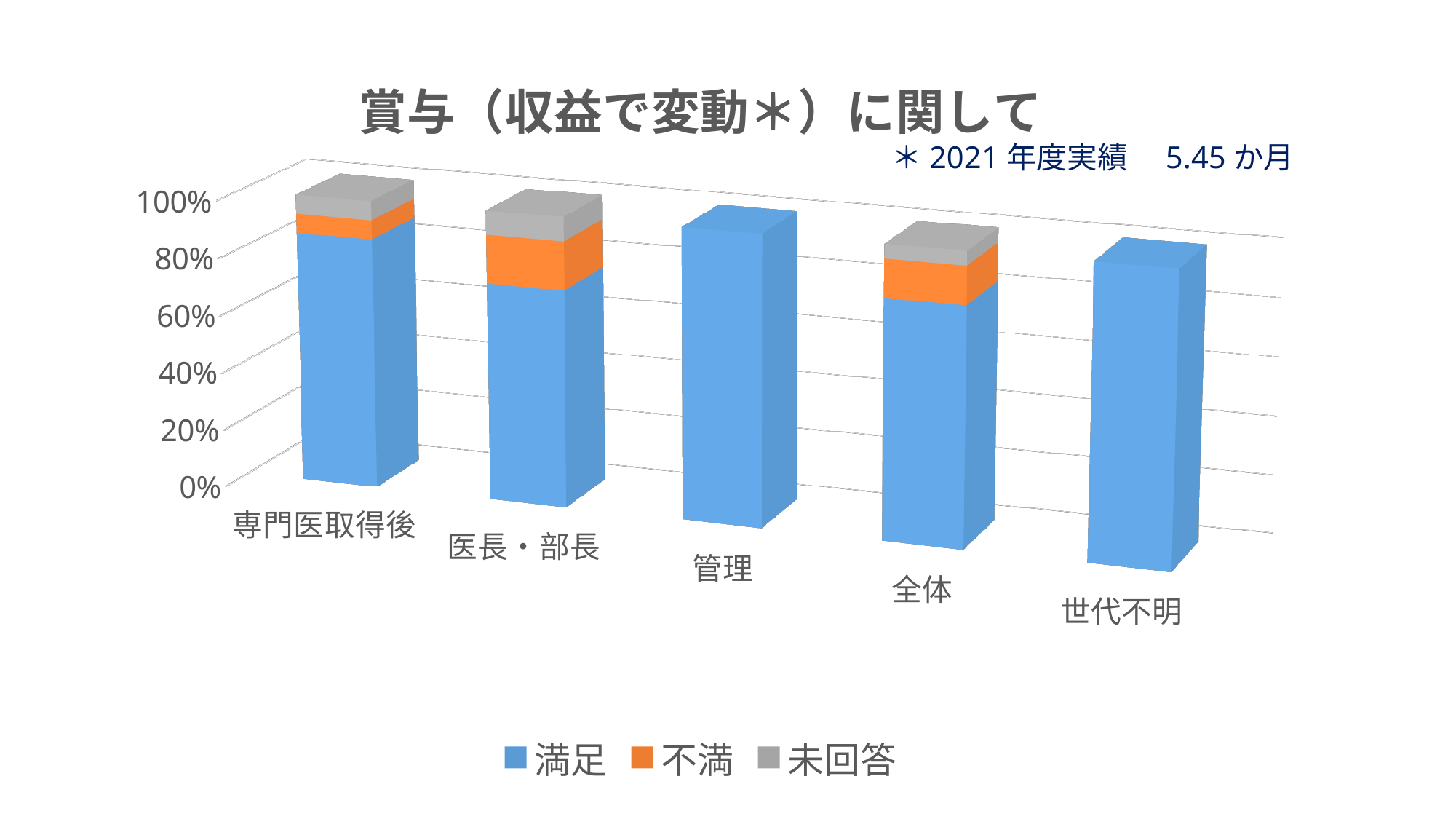
Which has the larger 不満 share, 医長・部長 or 専門医取得後? 医長・部長 What are the three legend entries of the chart? 満足, 不満, 未回答 Is the 満足 share for 医長・部長 greater or less than 40%? greater How many categories consist entirely of the 満足 series? 2 How many categories are shown on the x axis of the chart? 5 Is the 満足 share for 専門医取得後 greater or less than 60%? greater What is the title of the chart? 賞与（収益で変動＊）に関して Which has the larger 満足 share, 専門医取得後 or 全体? 専門医取得後 How many series does the legend list? 3 What kind of chart is shown on the slide? Stacked bar chart Which has the larger 満足 share, 管理 or 全体? 管理